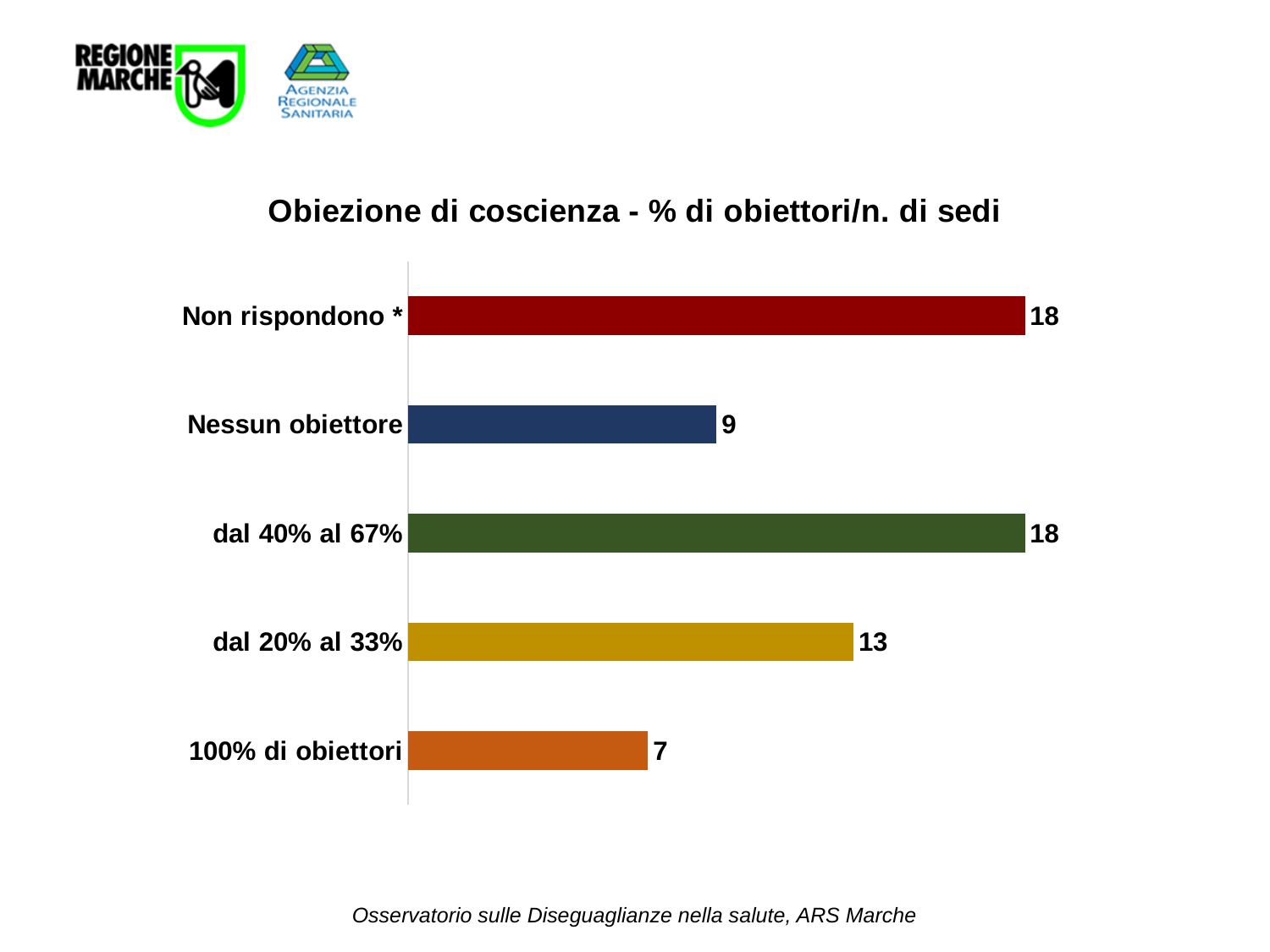
Which category has the lowest value? 100% di obiettori What is the difference between the values for "Nessun obiettore" and "100% di obiettori"? 2 What is the value for "100% di obiettori"? 7 How many categories are shown in the chart? 5 Which is larger, the value for "dal 20% al 33%" or the value for "Nessun obiettore"? dal 20% al 33% What is the title of the chart? Obiezione di coscienza - % di obiettori/n. di sedi What is the value for "Nessun obiettore"? 9 What is the value for "dal 20% al 33%"? 13 What colour is the bar for "Non rispondono *"? Dark red What kind of chart is shown on the slide? Bar chart What is the difference between the values for "dal 40% al 67%" and "dal 20% al 33%"? 5 What is the value for "dal 40% al 67%"? 18